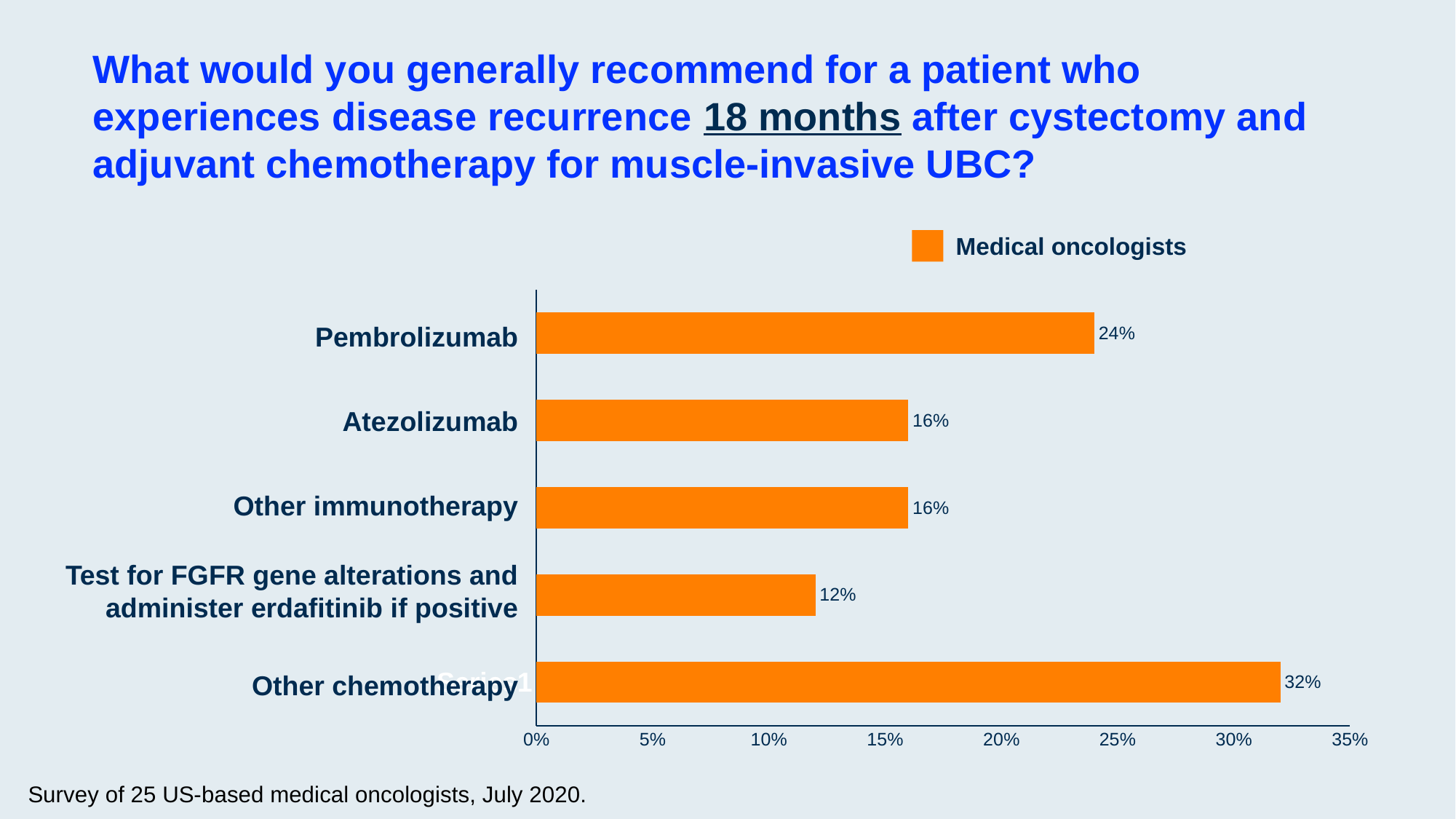
Which is larger, the value for Pembrolizumab or the value for Other immunotherapy? Pembrolizumab How many categories are shown in the chart? 5 What is the difference between the values for Other chemotherapy and Pembrolizumab? 8% Is the value for Other chemotherapy greater or less than 30%? greater Which category has the lowest value? Test for FGFR gene alterations and administer erdafitinib if positive What kind of chart is shown on the slide? Bar chart What series does the legend list? Medical oncologists What percentage of medical oncologists recommend Pembrolizumab? 24% What percentage is shown for 'Test for FGFR gene alterations and administer erdafitinib if positive'? 12% What is the value for Atezolizumab? 16% Which category has the highest value? Other chemotherapy What is the value for Other chemotherapy? 32%